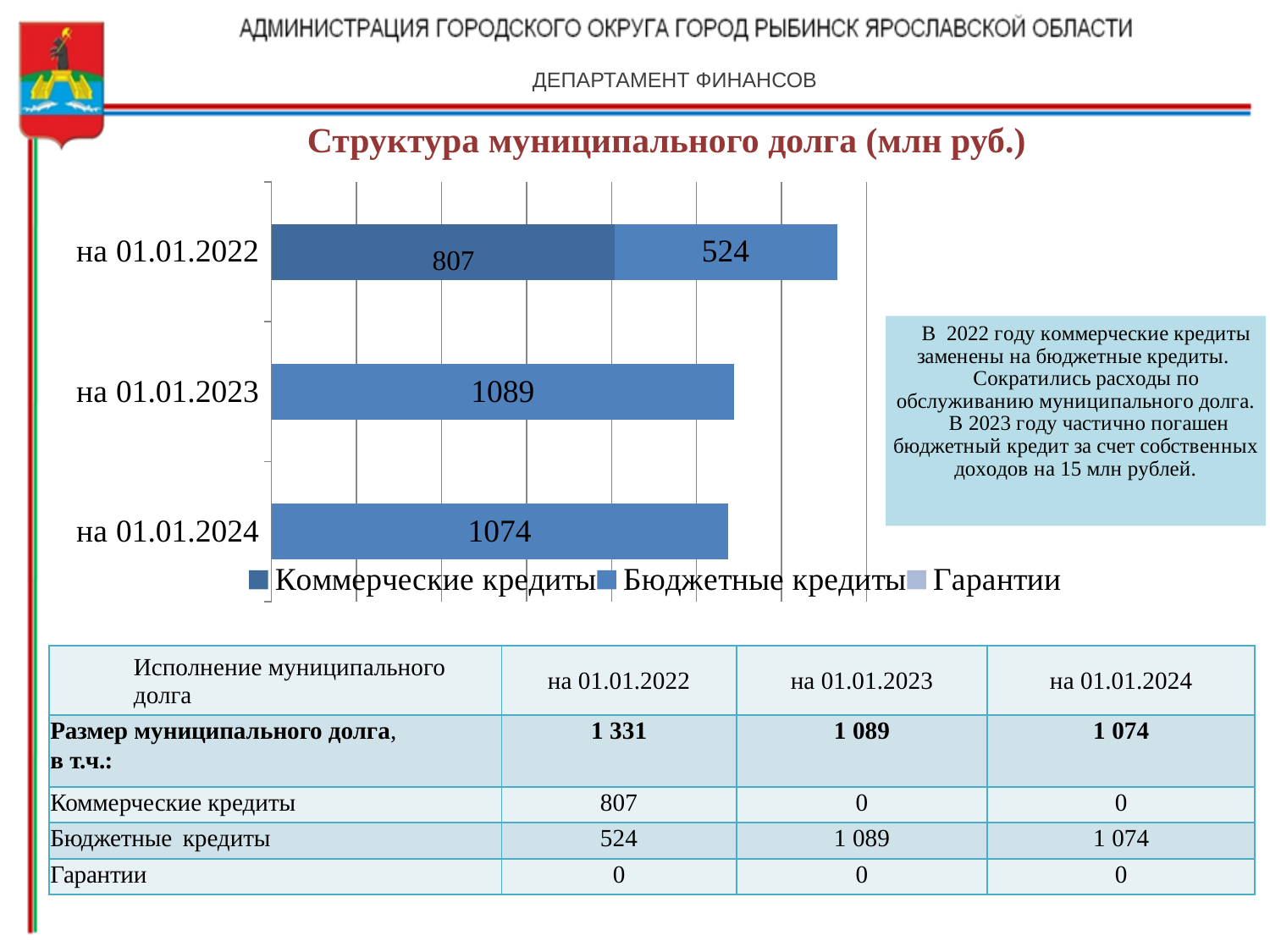
What is the value of Бюджетные кредиты for на 01.01.2023? 1089 Which is larger: Коммерческие кредиты or Бюджетные кредиты for на 01.01.2022? Коммерческие кредиты What is the title of the chart? Структура муниципального долга (млн руб.) What type of chart is shown on the slide? Stacked bar chart How many categories (dates) are shown on the chart? 3 What is the difference between Бюджетные кредиты for на 01.01.2023 and на 01.01.2024? 15 What is the total of the stacked bar for на 01.01.2022? 1331 What is the value of Коммерческие кредиты for на 01.01.2022? 807 What is the value of Бюджетные кредиты for на 01.01.2024? 1074 How many series does the chart legend list? 3 What is the value of Бюджетные кредиты for на 01.01.2022? 524 Which series is listed last in the chart legend? Гарантии